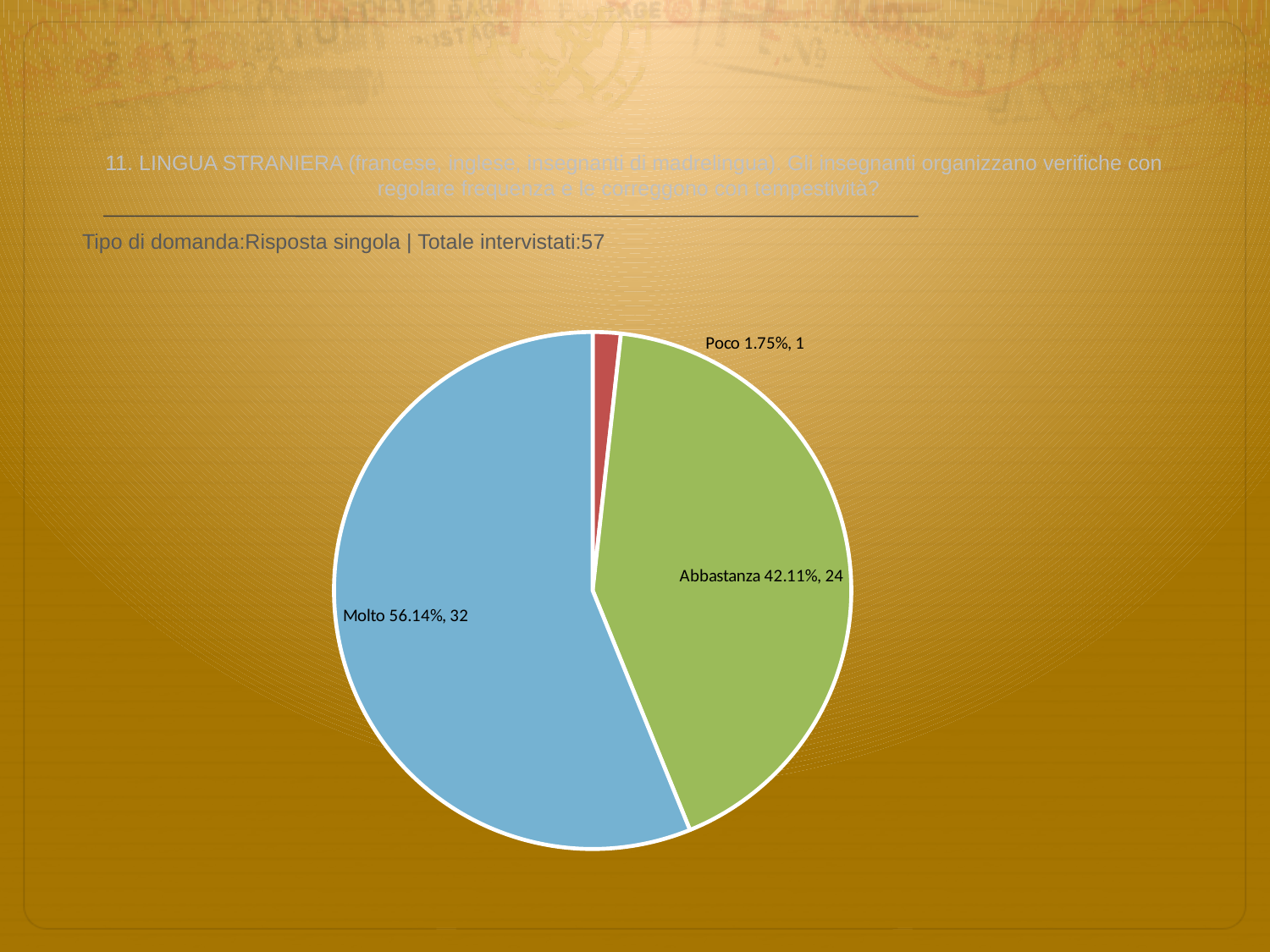
Which has more respondents, Abbastanza or Poco? Abbastanza What percentage share does the Poco slice have? 1.75% Which category has the smallest slice? Poco How many respondents answered Molto? 32 What percentage share does the Molto slice have? 56.14% How many respondents answered Abbastanza? 24 What kind of chart is shown on the slide? pie chart Which category has the largest slice? Molto What is the difference in respondent count between Molto and Abbastanza? 8 What percentage share does the Abbastanza slice have? 42.11% How many slices does the pie chart have? 3 How many respondents answered Poco? 1